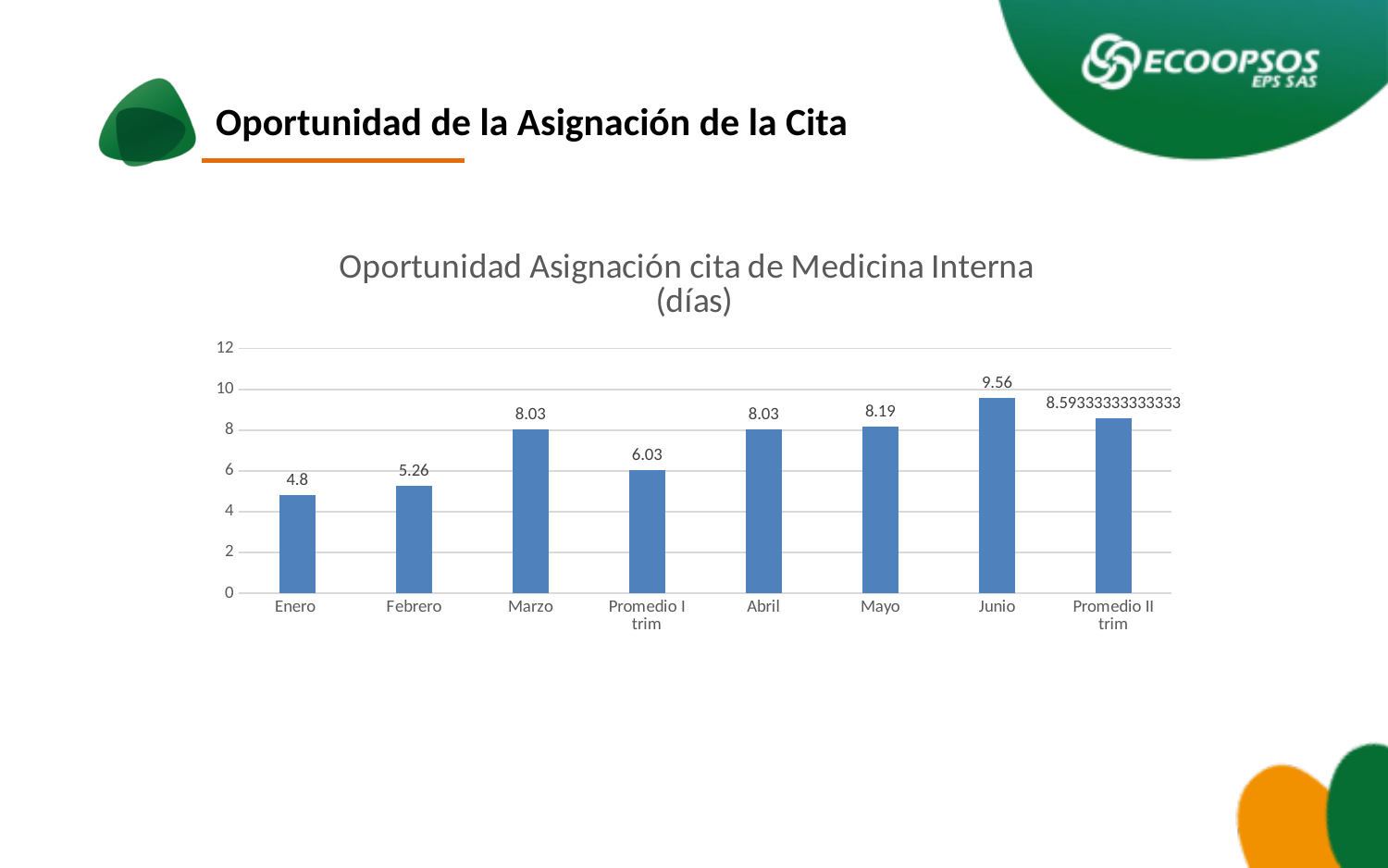
What is the value for Enero? 4.8 Which is larger, the value for Mayo or the value for Abril? Mayo What is the title of the chart? Oportunidad Asignación cita de Medicina Interna (días) What is the difference between the values for Junio and Enero? 4.76 What is the value for Promedio I trim? 6.03 What is the value for Promedio II trim? 8.59333333333333 Which category has the lowest value? Enero What is the value for Junio? 9.56 How many categories are shown on the x axis? 8 What kind of chart is shown? Bar chart Is the value for Febrero greater or less than 6? less Which category has the highest value? Junio